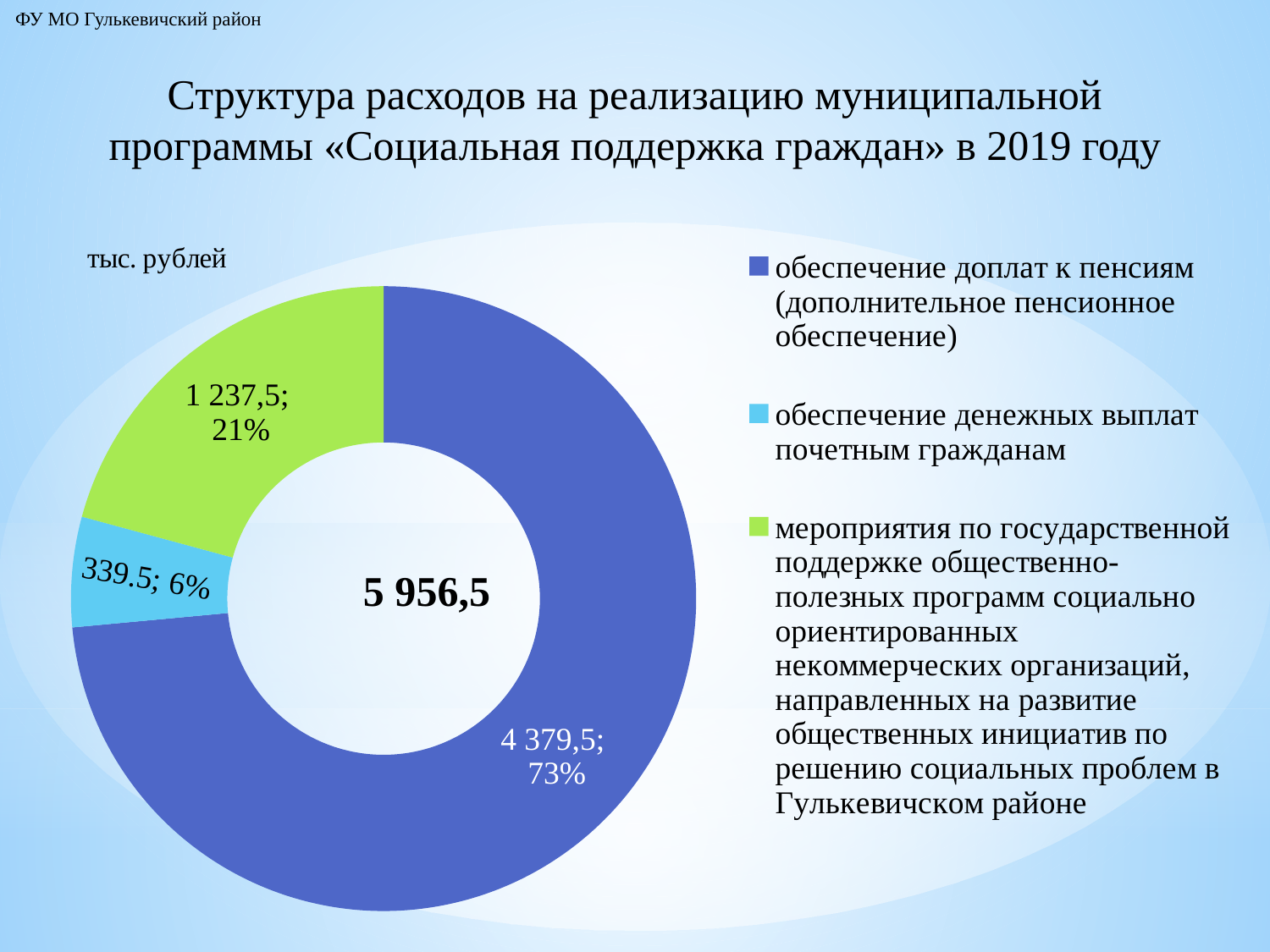
How many categories does the chart show? 3 What is the value for «обеспечение доплат к пенсиям (дополнительное пенсионное обеспечение)»? 4 379,5 Which category has the largest share of expenditure? обеспечение доплат к пенсиям (дополнительное пенсионное обеспечение) What is the value for «обеспечение денежных выплат почетным гражданам»? 339.5 What share of the total does «обеспечение доплат к пенсиям» account for? 73% What kind of chart is shown on the slide? Doughnut (pie) chart What share of the total does «обеспечение денежных выплат почетным гражданам» account for? 6% How many entries does the legend list? 3 Which category has the smallest share of expenditure? обеспечение денежных выплат почетным гражданам What is the total value shown in the centre of the chart? 5 956,5 What is the value for «мероприятия по государственной поддержке общественно-полезных программ социально ориентированных некоммерческих организаций...»? 1 237,5 What is the difference between the value for «обеспечение доплат к пенсиям» and the value for «мероприятия по государственной поддержке...»? 3 142